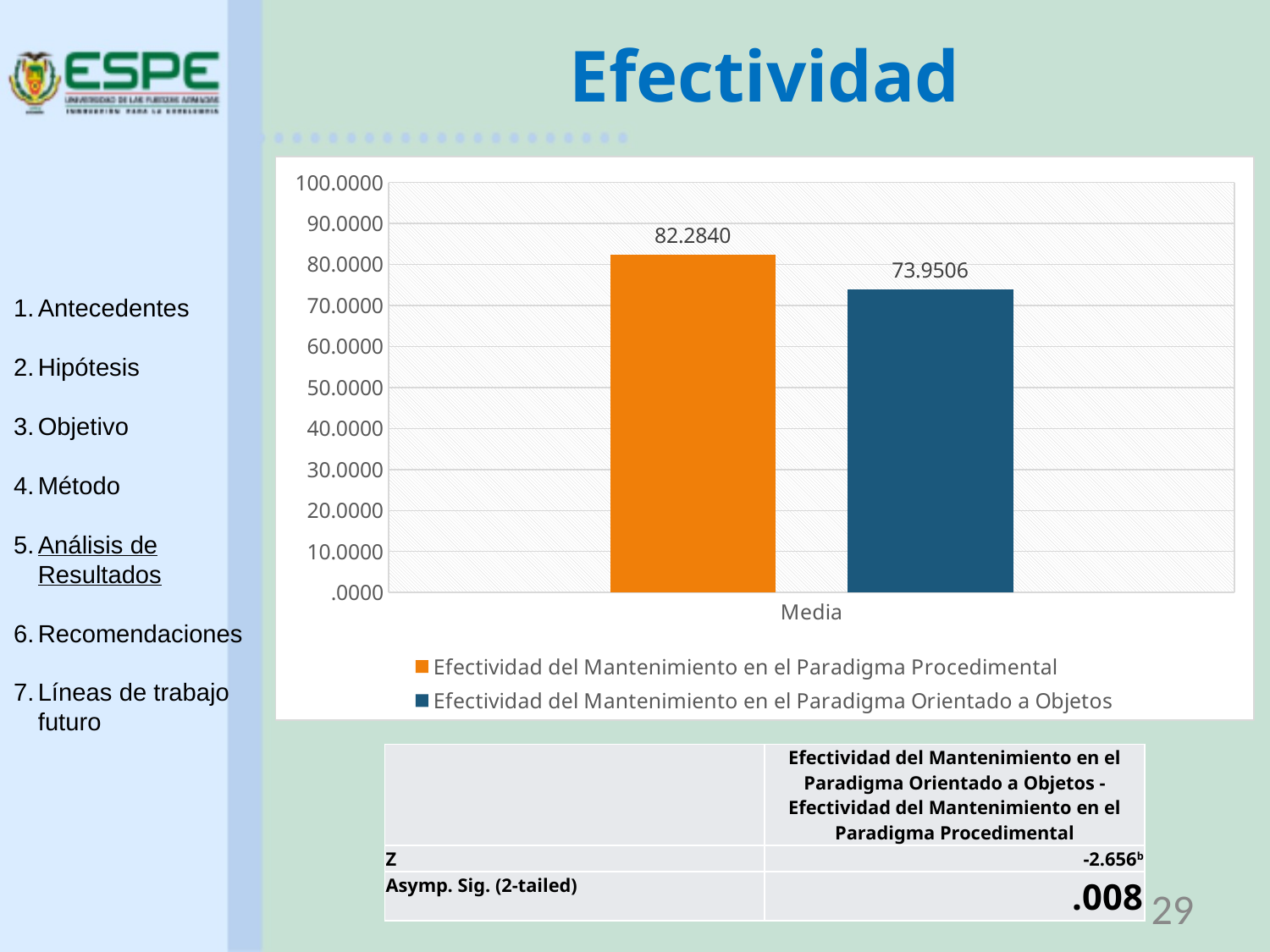
What is the difference between the Paradigma Procedimental value and the Paradigma Orientado a Objetos value? 8.3334 Which series has the lower value in the chart? Efectividad del Mantenimiento en el Paradigma Orientado a Objetos How many series does the legend list? 2 Which is larger: the Paradigma Procedimental bar or the Paradigma Orientado a Objetos bar? Paradigma Procedimental What colour is the bar for Efectividad del Mantenimiento en el Paradigma Procedimental? orange What is the value of the bar for Efectividad del Mantenimiento en el Paradigma Procedimental? 82.2840 Is the value for Efectividad del Mantenimiento en el Paradigma Orientado a Objetos greater or less than 80.0000? less What kind of chart is shown on the slide? bar chart Is the value for Efectividad del Mantenimiento en el Paradigma Procedimental greater or less than 80.0000? greater What is the value of the bar for Efectividad del Mantenimiento en el Paradigma Orientado a Objetos? 73.9506 Which series has the higher value in the chart? Efectividad del Mantenimiento en el Paradigma Procedimental What is the category label shown on the x axis of the chart? Media